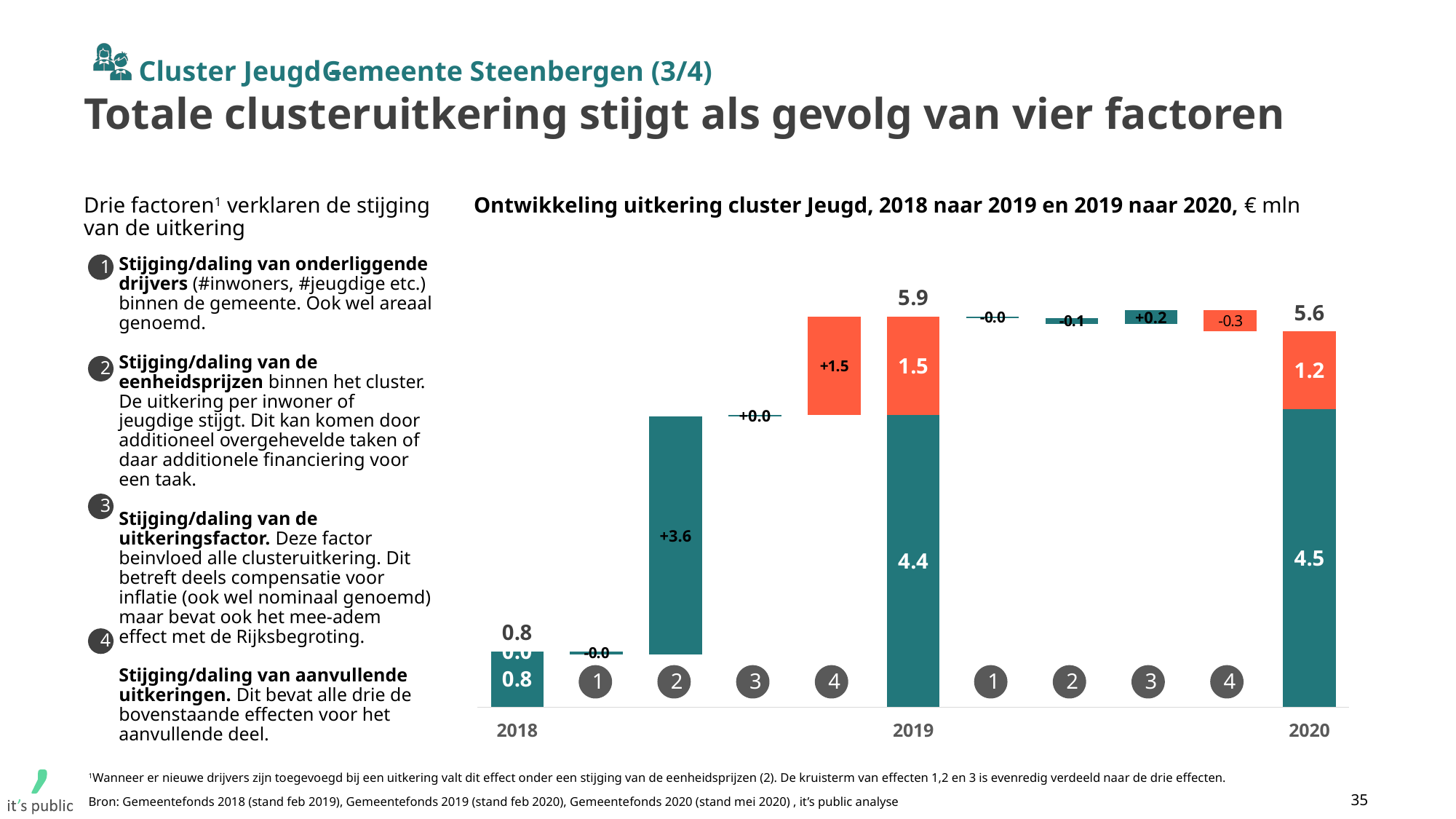
What is the value of the factor 3 step between 2019 and 2020? +0.2 What is the total uitkering for cluster Jeugd in 2020 shown on the chart? 5.6 What is the total uitkering for cluster Jeugd in 2019 shown on the chart? 5.9 What is the value of the factor 2 step between 2018 and 2019? +3.6 What is the difference between the 2019 total (5.9) and the 2020 total (5.6)? 0.3 What is the value of the orange (upper) segment of the 2020 bar? 1.2 What is the total uitkering for cluster Jeugd in 2018 shown on the chart? 0.8 What is the value of the teal (lower) segment of the 2019 bar? 4.4 What kind of chart is shown on the slide? Bar chart (waterfall) Which year has the highest total uitkering on the chart? 2019 What is the value of the factor 4 step between 2018 and 2019? +1.5 What is the value of the factor 4 step between 2019 and 2020? -0.3